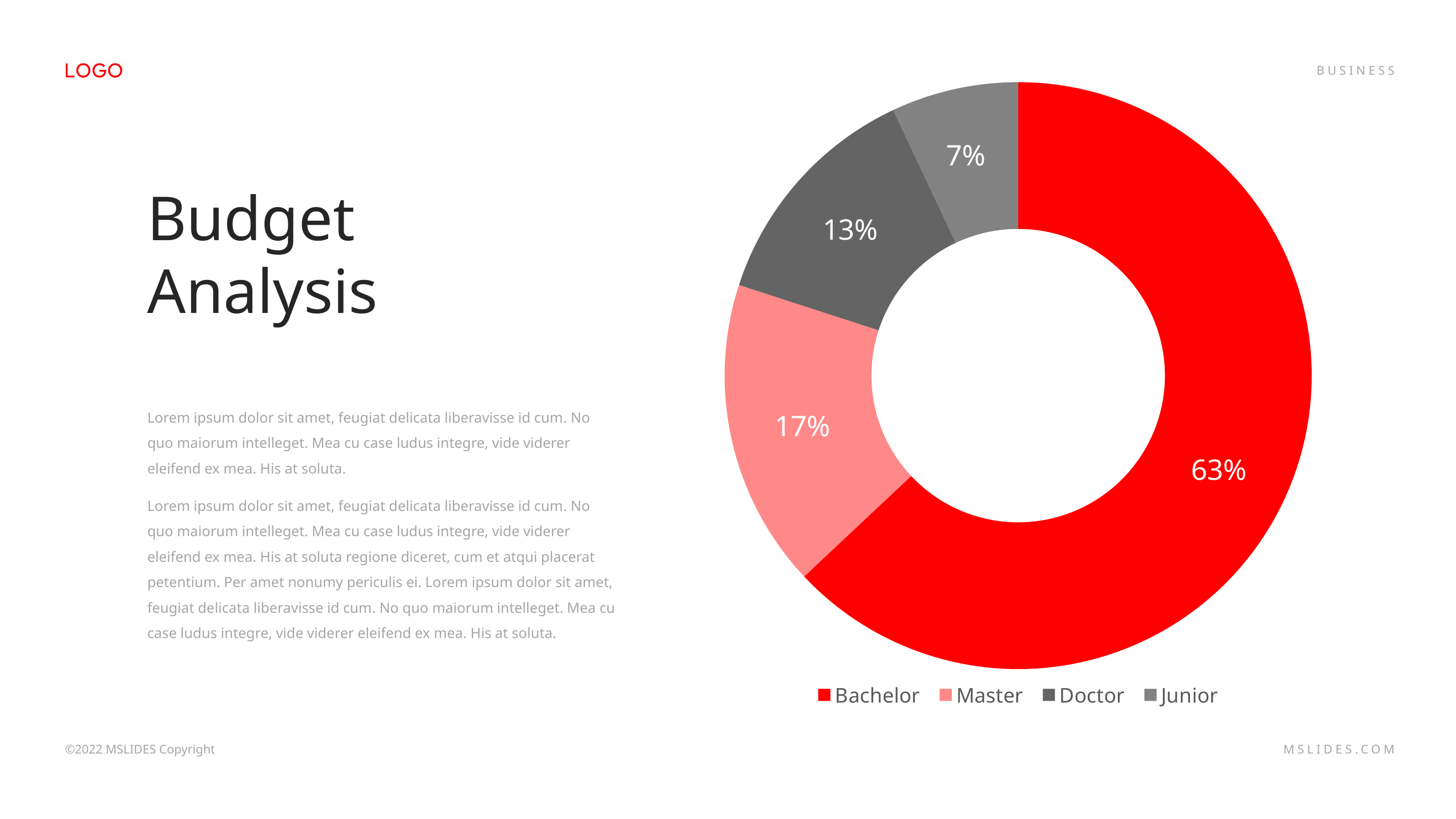
What percentage is shown for Master? 17% What percentage is shown for Doctor? 13% Which is larger, the share for Master or the share for Doctor? Master Which category has the largest share of the chart? Bachelor Which category has the smallest share of the chart? Junior What kind of chart is shown on the slide? Doughnut chart How many categories does the chart show? 4 What colour is the Bachelor segment in the chart? Red What percentage is shown for Junior? 7% What is the difference in percentage points between Doctor and Junior? 6 What percentage of the chart does Bachelor account for? 63% What is the difference in percentage points between Bachelor and Master? 46